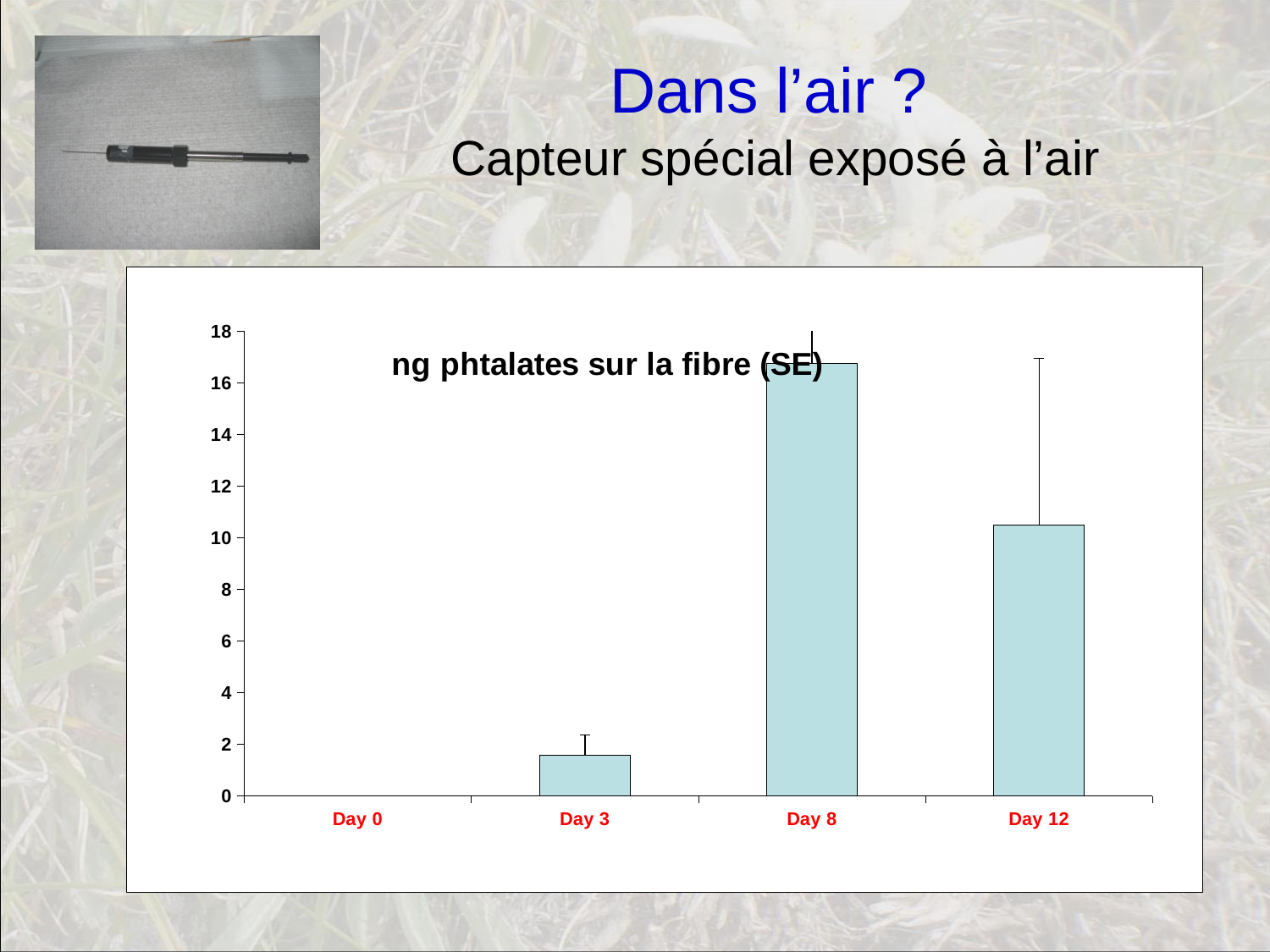
Does the value rise or fall from Day 8 to Day 12? fall How many categories are shown on the x axis of the chart? 4 Which day has the lowest value in the chart? Day 0 Is the value for Day 8 greater or less than 16? greater What is the title of the chart? ng phtalates sur la fibre (SE) Is the value for Day 3 greater or less than 2? less Does the value rise or fall from Day 3 to Day 8? rise What kind of chart is shown on the slide? bar chart Which has the larger value, Day 3 or Day 12? Day 12 Which has the larger value, Day 8 or Day 12? Day 8 Is the value for Day 12 greater or less than 12? less Which day has the highest value in the chart? Day 8